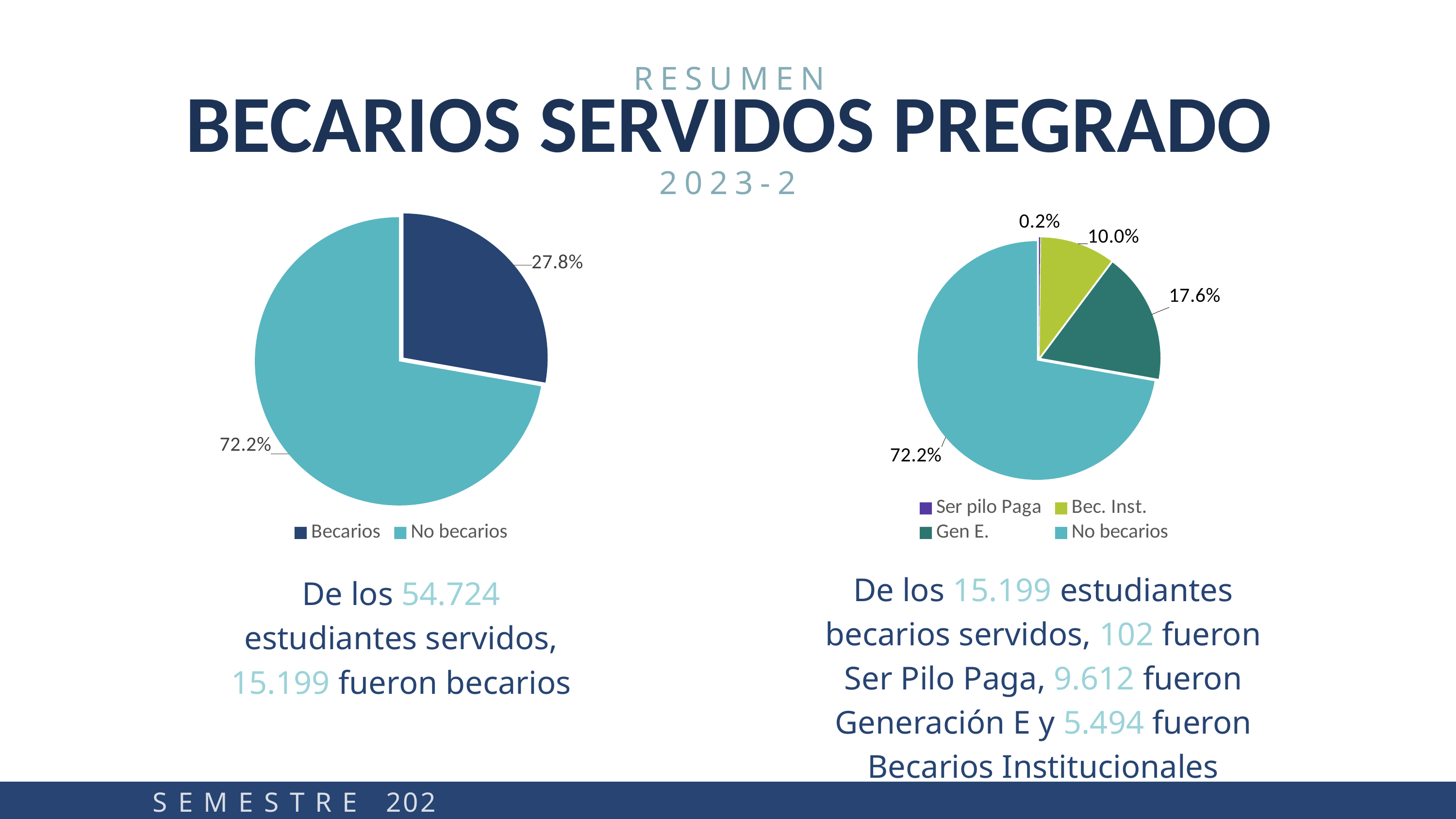
In the right pie chart, what share is labelled for Bec. Inst.? 10.0% In the right pie chart, what share is labelled for Gen E.? 17.6% In the left pie chart, what is the difference between the No becarios share and the Becarios share? 44.4% In the left pie chart, what share of the pie is labelled No becarios? 72.2% In the right pie chart, which slice is the smallest? Ser pilo Paga In the left pie chart, which slice is the largest? No becarios What type of chart is the left chart on the slide? Pie chart How many entries does the legend of the left pie chart list? 2 In the right pie chart, which is larger, the Gen E. slice or the Bec. Inst. slice? Gen E. In the right pie chart, what colour is the No becarios slice? Teal How many slices does the right pie chart have? 4